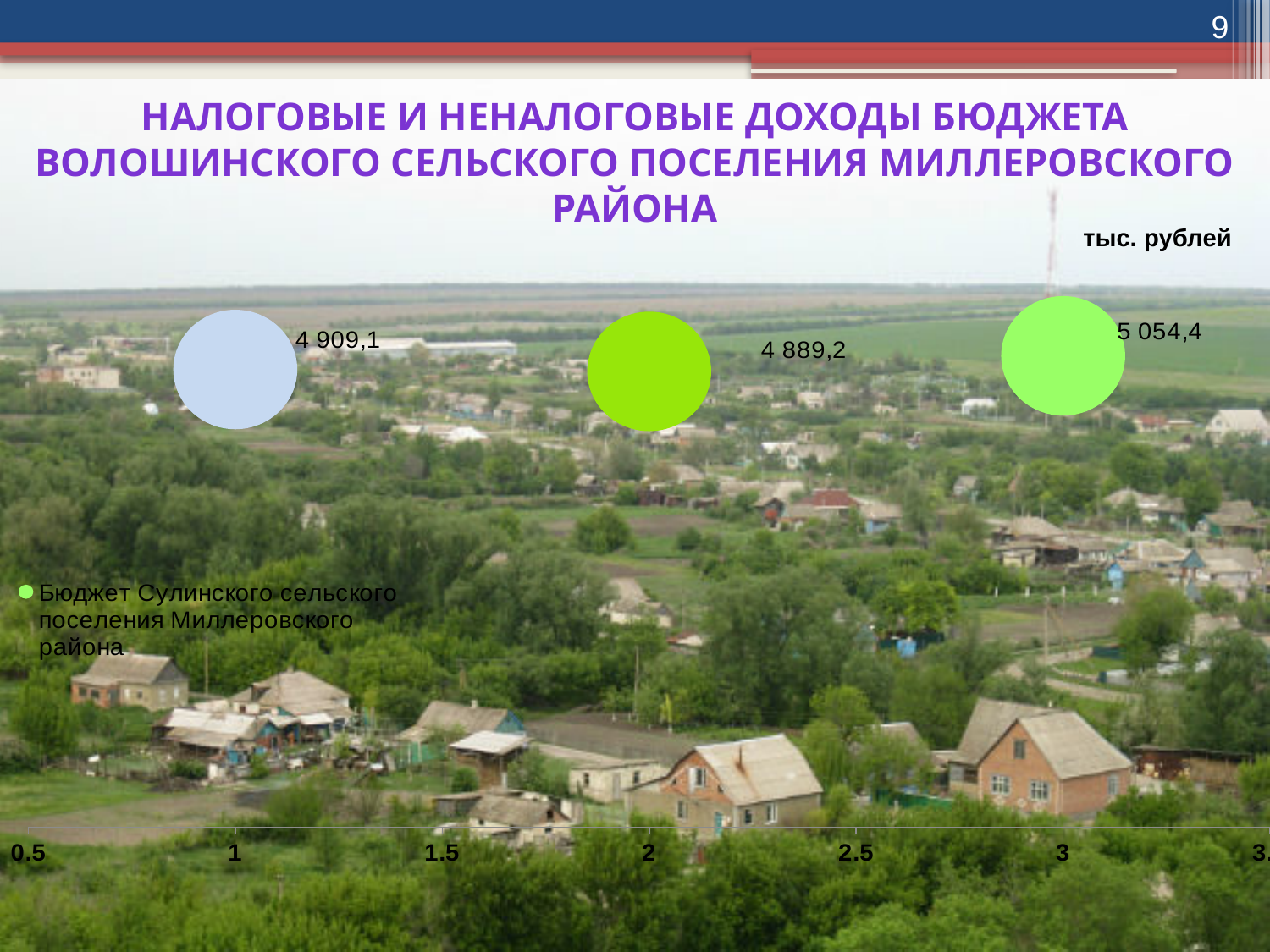
What value is labelled on the leftmost bubble? 4 909,1 How many series does the legend list? 1 In what units are the values on the chart given? тыс. рублей What value is labelled on the middle bubble? 4 889,2 Which bubble has the highest value? the rightmost bubble (5 054,4) How many bubbles are plotted on the chart? 3 What is the difference between the rightmost bubble's value and the leftmost bubble's value? 145,3 What value is labelled on the rightmost bubble? 5 054,4 What is the difference between the leftmost bubble's value and the middle bubble's value? 19,9 Which is larger, the value of the leftmost bubble or the value of the middle bubble? the leftmost bubble (4 909,1) Which bubble has the lowest value? the middle bubble (4 889,2) What kind of chart is shown on the slide? bubble chart